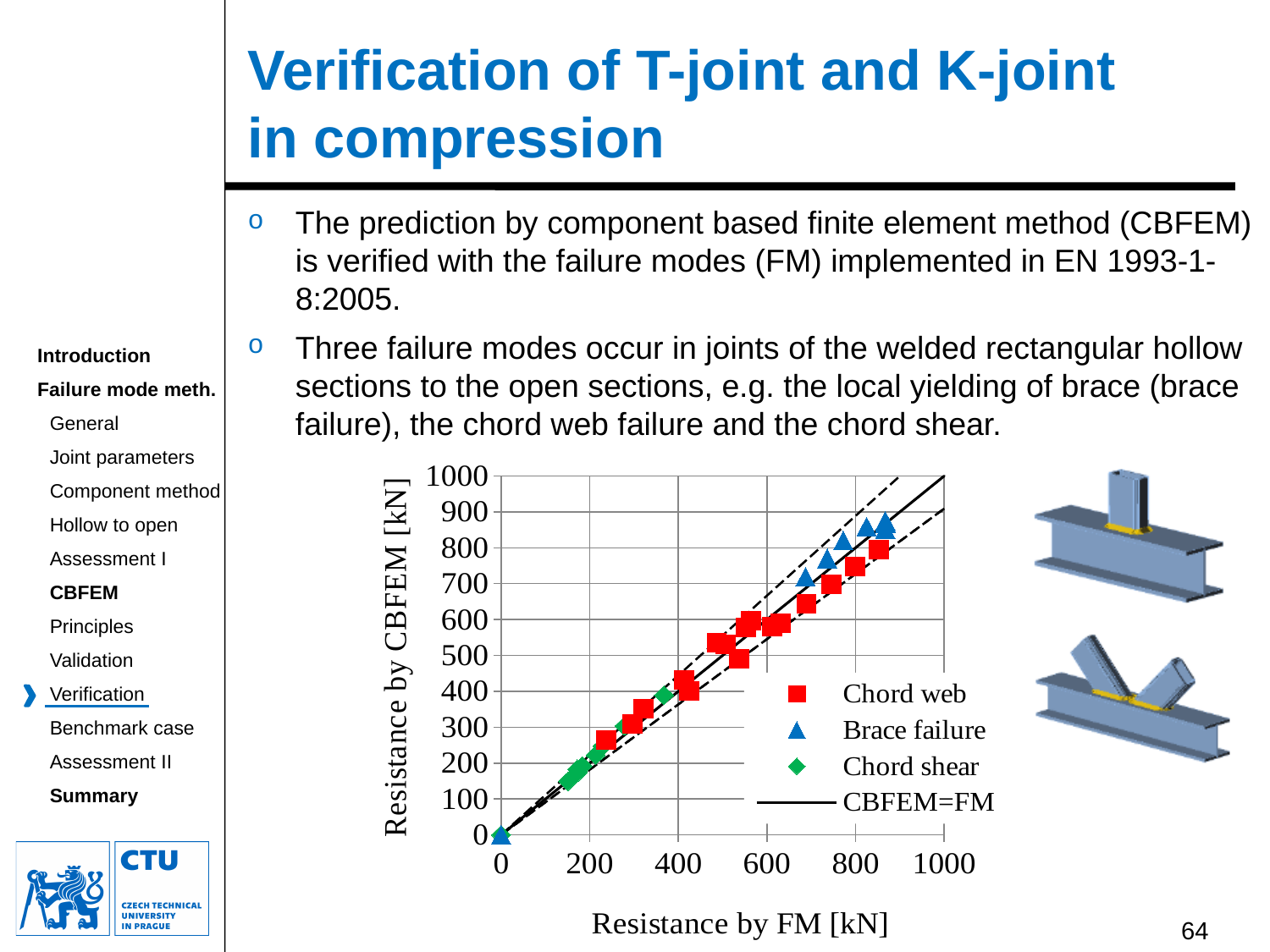
What kind of chart is shown on the slide? Scatter chart How many entries does the chart legend list? 4 What is the label of the chart's y axis? Resistance by CBFEM [kN] Which series reaches higher Resistance by CBFEM values, Chord shear or Brace failure? Brace failure Is the lowest Resistance by FM value for the Chord web series greater or less than 400? less Do the plotted points rise or fall as Resistance by FM increases along the x axis? Rise Is the highest Resistance by CBFEM value for the Chord web series greater or less than 900? less Is the highest Resistance by CBFEM value for the Brace failure series greater or less than 800? greater What is the maximum value shown on the chart's y axis? 1000 What is the label of the chart's x axis? Resistance by FM [kN] Which series contains the point with the highest Resistance by CBFEM? Brace failure